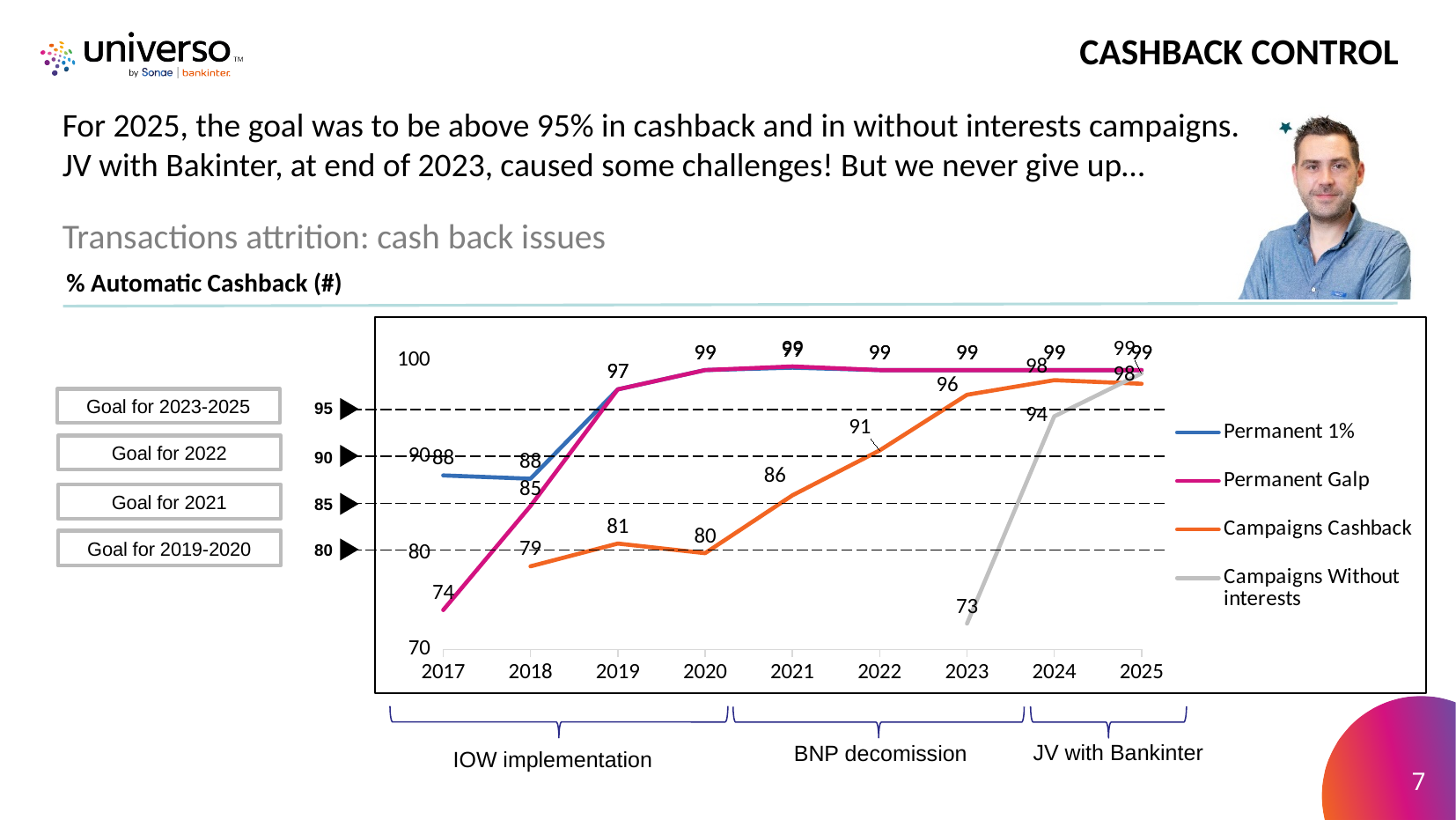
In 2018, which is higher: Permanent 1% or Permanent Galp? Permanent 1% Is the value for Campaigns Cashback in 2021 greater or less than 90? less How many series does the legend list? 4 What is the value for Permanent Galp in 2017? 74 By how much did Campaigns Cashback increase from 2022 to 2023? 5 What is the value for Campaigns Without interests in 2024? 94 In which year is Campaigns Cashback at its lowest? 2018 How many years are shown on the x axis? 9 What is the value for Campaigns Without interests in 2023? 73 Does Campaigns Cashback rise or fall from 2020 to 2023? rise What type of chart is shown on the slide? line chart What is the value for Campaigns Cashback in 2022? 91